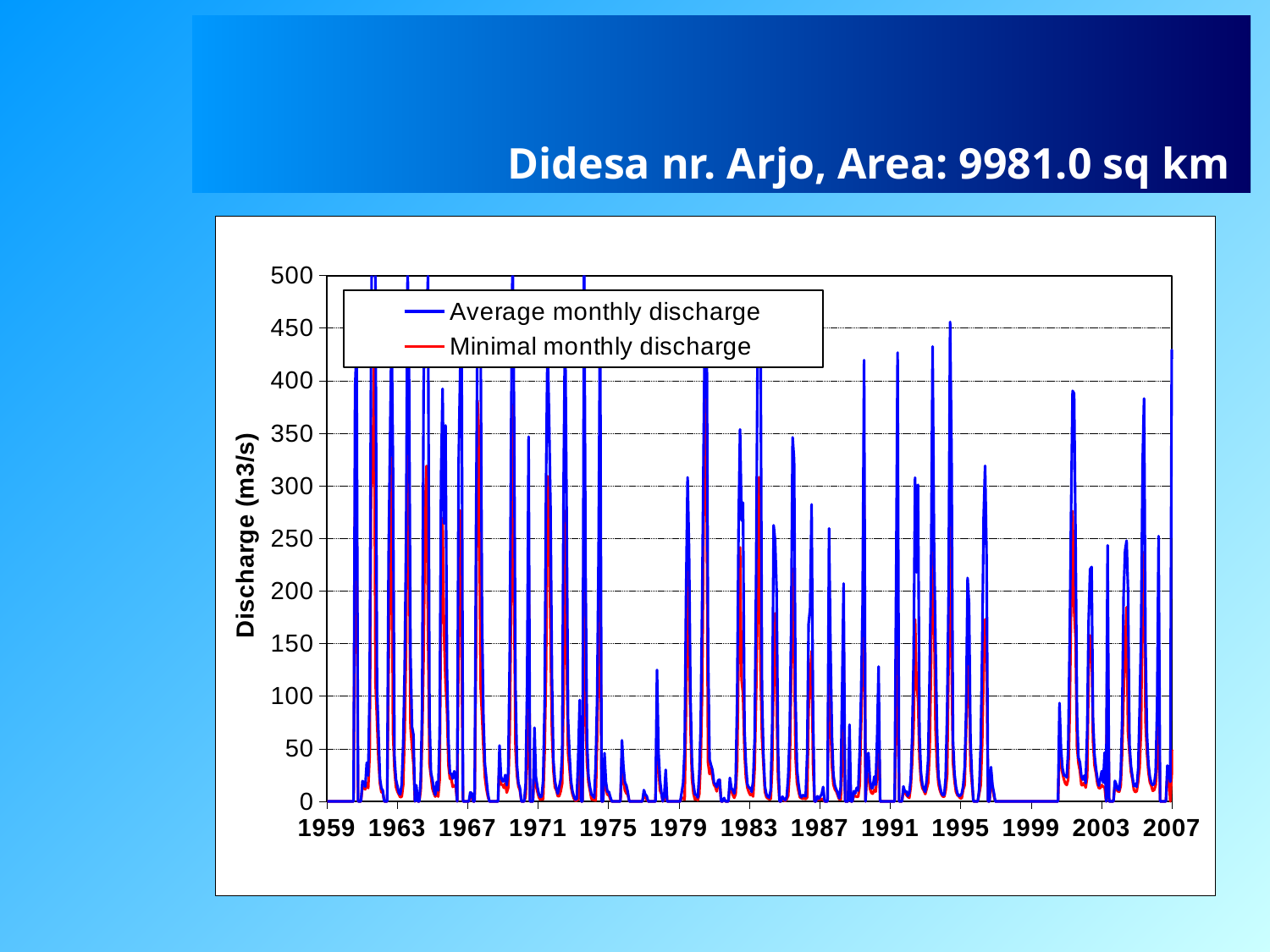
What is the label of the y axis? Discharge (m3/s) Are the discharge values between 1997 and 2000 greater or less than 50? less What are the two series named in the legend? Average monthly discharge; Minimal monthly discharge What is the highest value shown on the y axis? 500 How many series does the legend list? 2 What kind of chart is shown on the slide? line chart Is the highest peak of Average monthly discharge between 1991 and 1995 greater or less than 400? greater Which series generally reaches higher values, Average monthly discharge or Minimal monthly discharge? Average monthly discharge